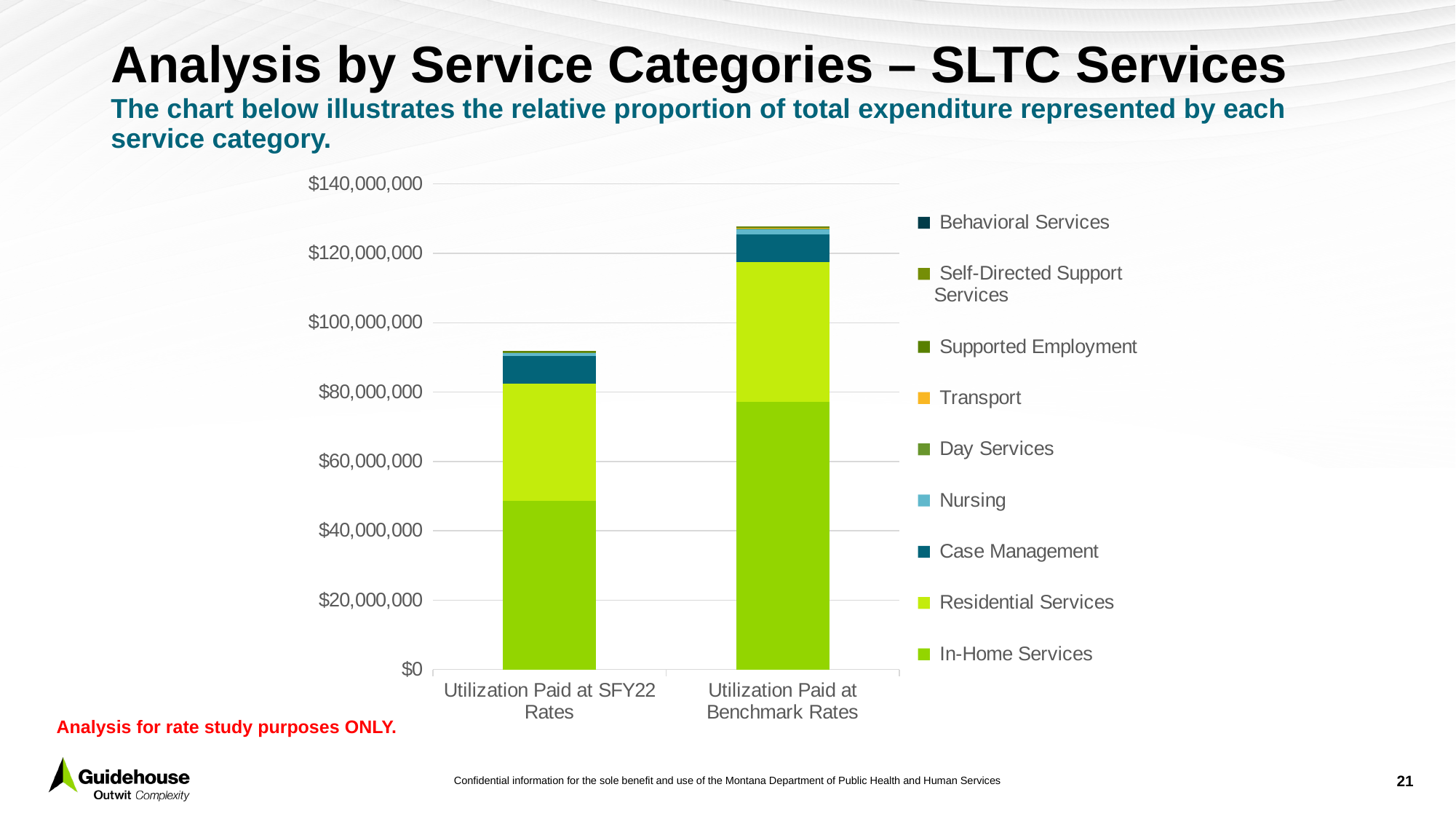
How many series does the legend list? 9 How many bars (categories) are plotted on the x axis? 2 Is the In-Home Services segment of the Utilization Paid at SFY22 Rates bar greater or less than $40,000,000? greater Is the total of the Utilization Paid at SFY22 Rates bar greater or less than $100,000,000? less Is the total of the Utilization Paid at SFY22 Rates bar greater or less than $80,000,000? greater What kind of chart is shown on the slide? Stacked bar chart Which legend entry is listed first, at the top of the legend? Behavioral Services Which service category makes up the largest segment of the Utilization Paid at Benchmark Rates bar? In-Home Services Which bar has the greater total expenditure, Utilization Paid at SFY22 Rates or Utilization Paid at Benchmark Rates? Utilization Paid at Benchmark Rates